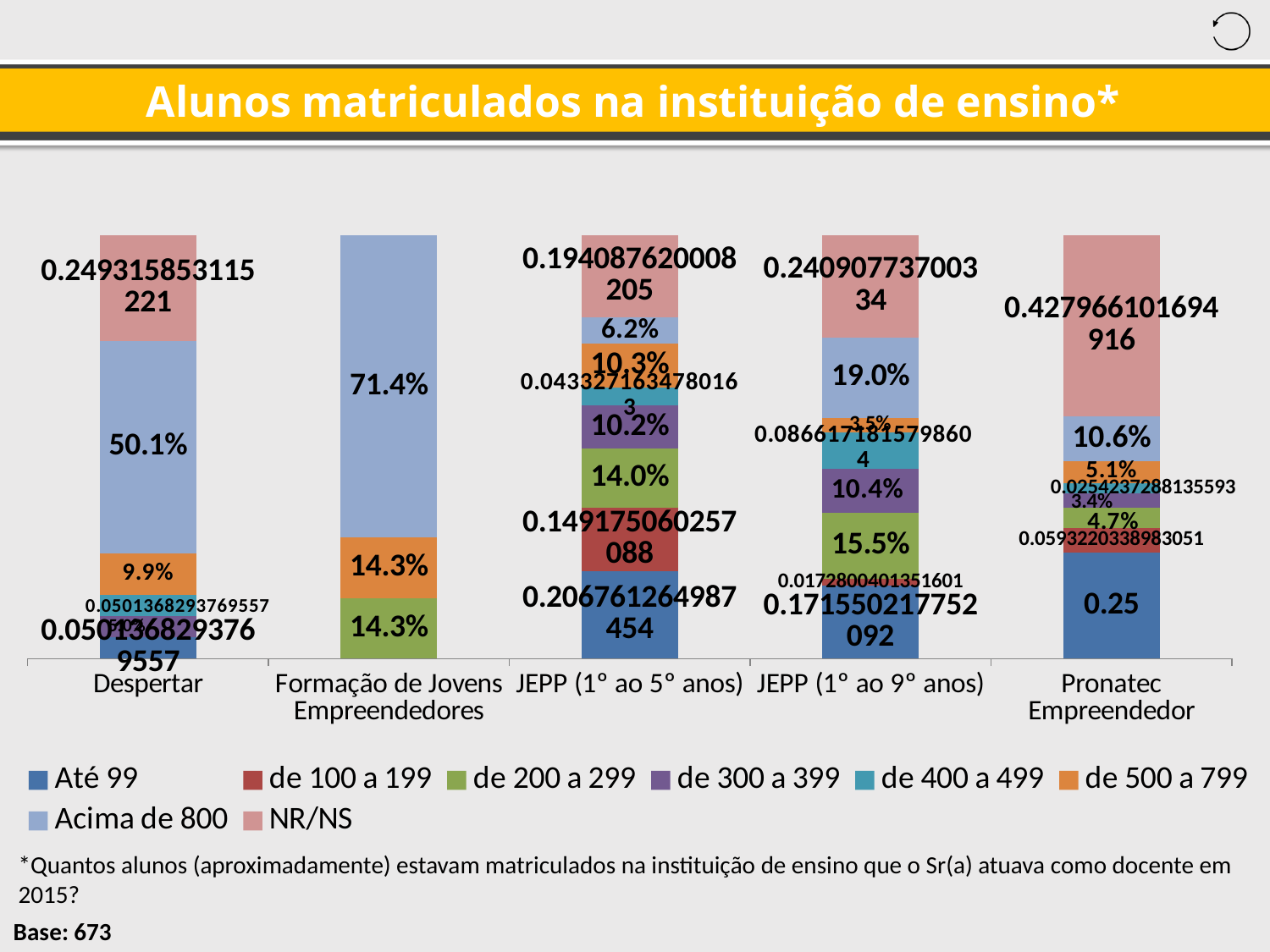
How many series does the legend list? 8 What kind of chart is shown on the slide? Stacked bar chart What is the value of 'de 200 a 299' for JEPP (1° ao 5° anos)? 14.0% What is the value of 'Acima de 800' for Despertar? 50.1% What is the value of 'Acima de 800' for JEPP (1° ao 9° anos)? 19.0% Which is larger: the 'de 200 a 299' share for JEPP (1° ao 9° anos) or for JEPP (1° ao 5° anos)? JEPP (1° ao 9° anos) What is the title of the chart? Alunos matriculados na instituição de ensino* How many categories (programs) are shown along the x axis? 5 What is the value of 'Acima de 800' for Formação de Jovens Empreendedores? 71.4% Which category has the highest share for 'Acima de 800'? Formação de Jovens Empreendedores What is the difference in percentage points between the 'Acima de 800' share for Formação de Jovens Empreendedores and for Despertar? 21.3 What is the value of 'Acima de 800' for Pronatec Empreendedor? 10.6%